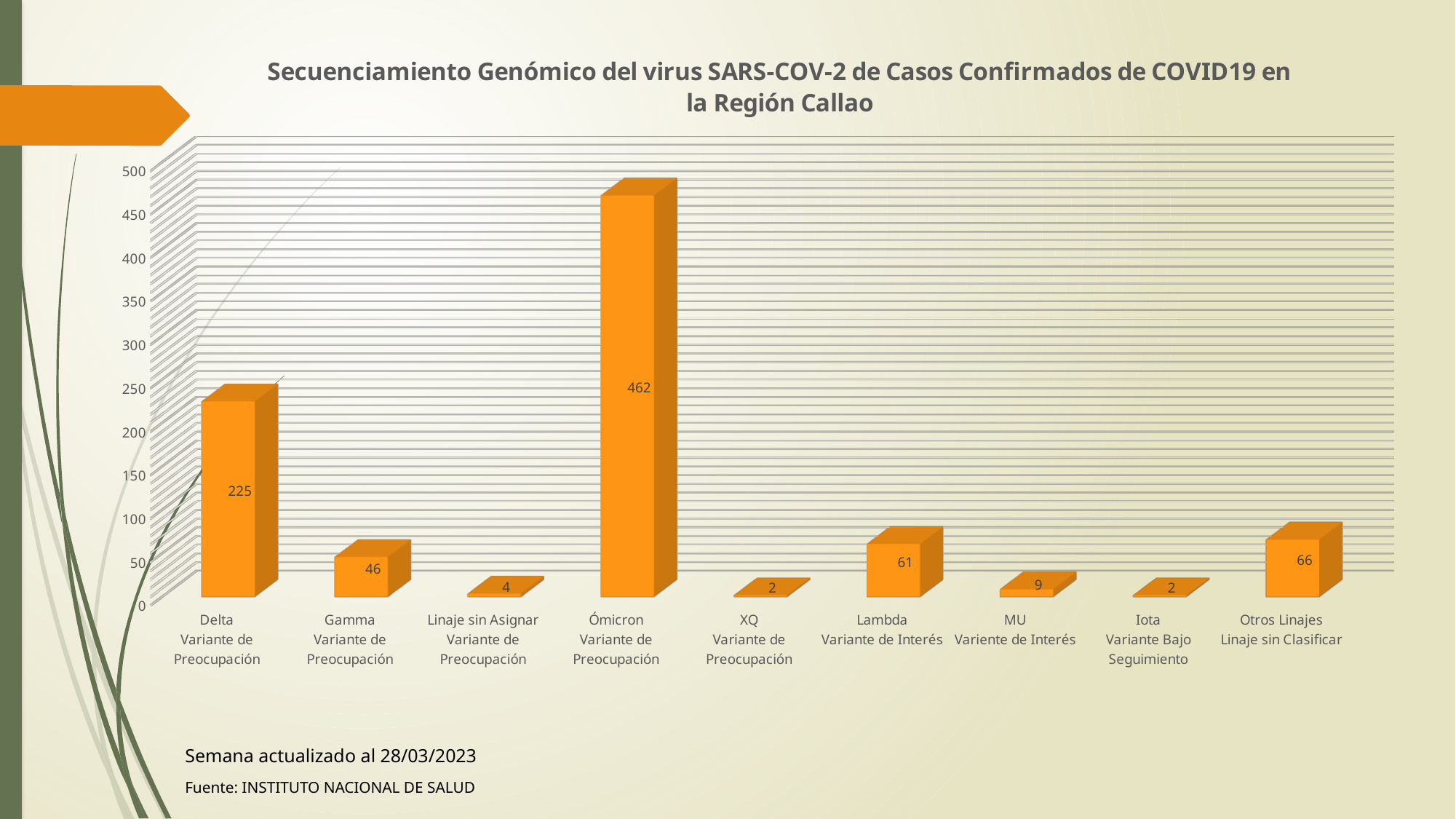
What is the value for Delta? 225 What is the value for Lambda? 61 How many categories are shown on the x axis? 9 Which is larger, the value for Lambda or the value for Gamma? Lambda What is the difference between the values for Otros Linajes and Gamma? 20 Which category has the highest value? Ómicron What kind of chart is shown on the slide? Bar chart What is the value for MU? 9 What is the source cited below the chart? INSTITUTO NACIONAL DE SALUD What is the value for Ómicron? 462 What is the difference between the values for Ómicron and Delta? 237 What is the value for Otros Linajes? 66